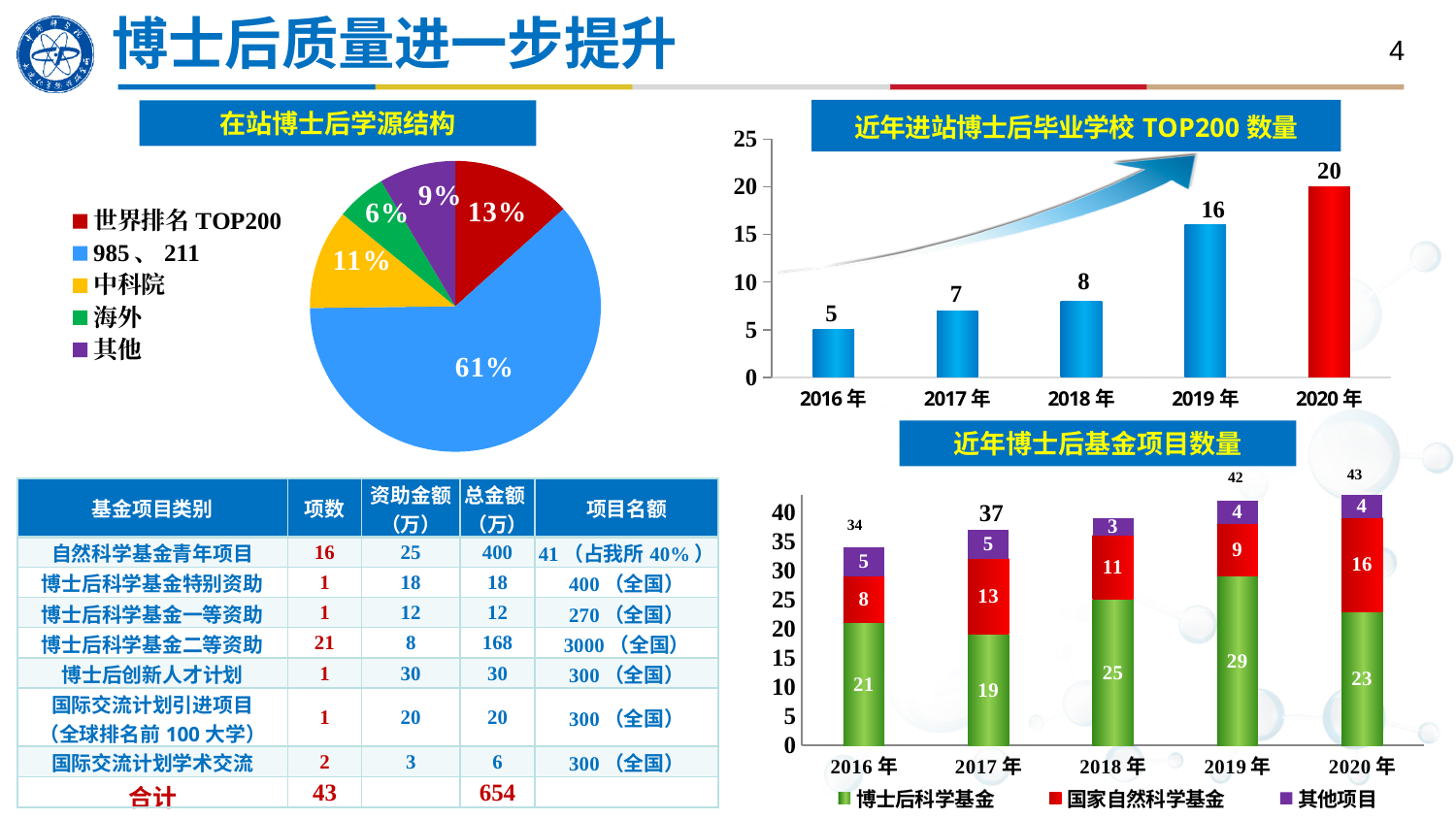
In the pie chart titled 在站博士后学源结构, what is the value for 海外? 6% In the pie chart titled 在站博士后学源结构, what share does 985、211 have? 61% In the chart titled 近年博士后基金项目数量, what is the total of the stacked bar for 2020年? 43 In the chart titled 近年博士后基金项目数量, what is the value of 博士后科学基金 for 2019年? 29 In the chart titled 近年博士后基金项目数量, how many series does the legend list? 3 In the chart titled 近年进站博士后毕业学校 TOP200 数量, what is the value for 2019年? 16 In the pie chart titled 在站博士后学源结构, how many categories does the legend list? 5 In the pie chart titled 在站博士后学源结构, which category has the smallest slice? 海外 In the chart titled 近年进站博士后毕业学校 TOP200 数量, do the values rise or fall from 2016年 to 2020年? rise In the chart titled 近年进站博士后毕业学校 TOP200 数量, what is the difference between the values for 2020年 and 2016年? 15 What kind of chart is the one titled 近年进站博士后毕业学校 TOP200 数量? bar chart In the chart titled 近年博士后基金项目数量, which is larger, 国家自然科学基金 for 2017年 or for 2018年? 2017年